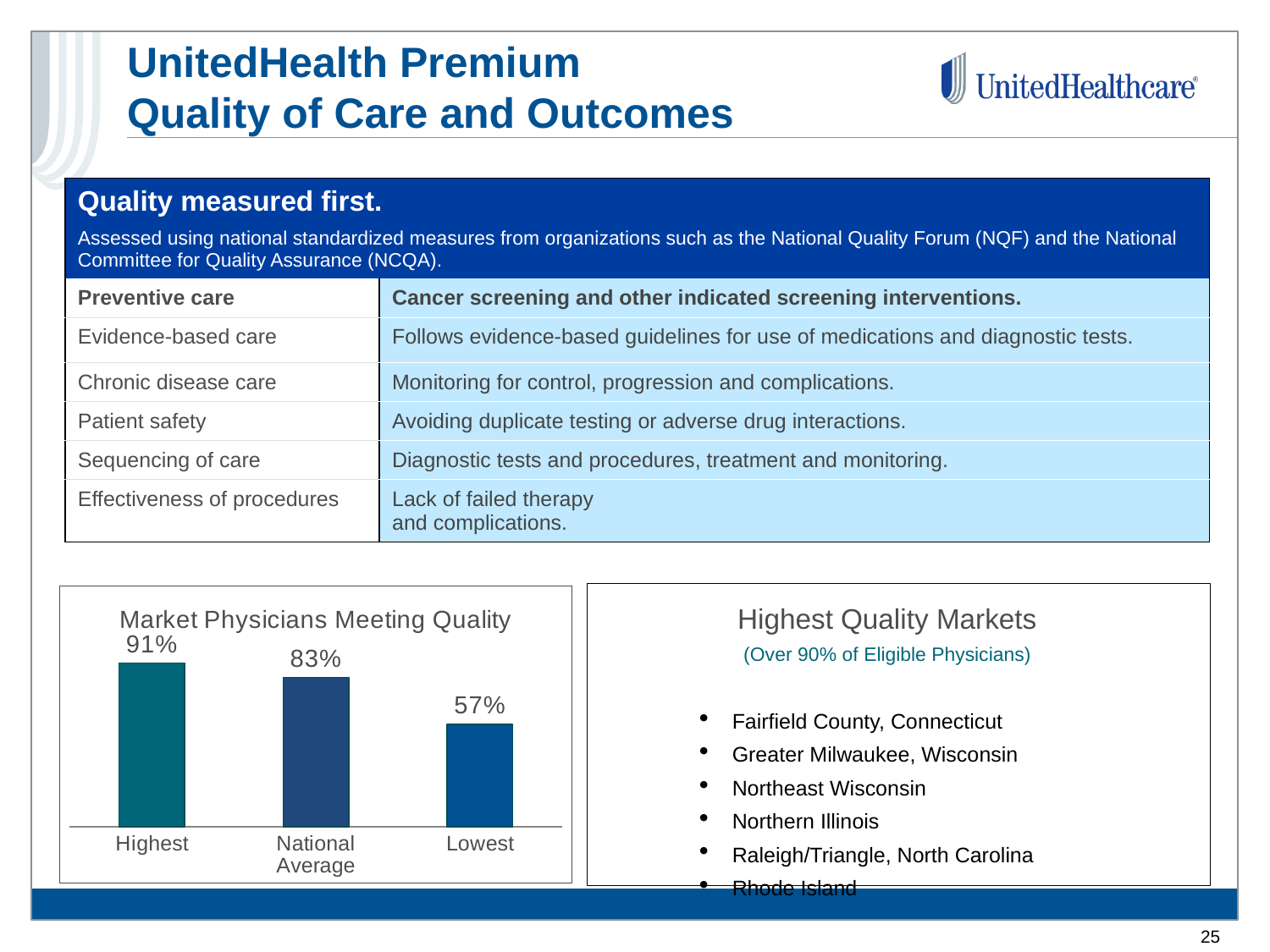
Which is larger in the Market Physicians Meeting Quality chart, National Average or Lowest? National Average How many categories are shown in the Market Physicians Meeting Quality chart? 3 What is the value for Highest in the Market Physicians Meeting Quality chart? 91% What is the value for Lowest in the Market Physicians Meeting Quality chart? 57% Which category has the lowest value in the Market Physicians Meeting Quality chart? Lowest What is the value for National Average in the Market Physicians Meeting Quality chart? 83% What kind of chart is the Market Physicians Meeting Quality chart? Bar chart Do the values in the Market Physicians Meeting Quality chart rise or fall from left to right? Fall What is the difference between the Highest and Lowest values in the Market Physicians Meeting Quality chart? 34% What is the difference between the Highest and National Average values in the Market Physicians Meeting Quality chart? 8% What is the title of the chart on the slide? Market Physicians Meeting Quality Which category has the highest value in the Market Physicians Meeting Quality chart? Highest